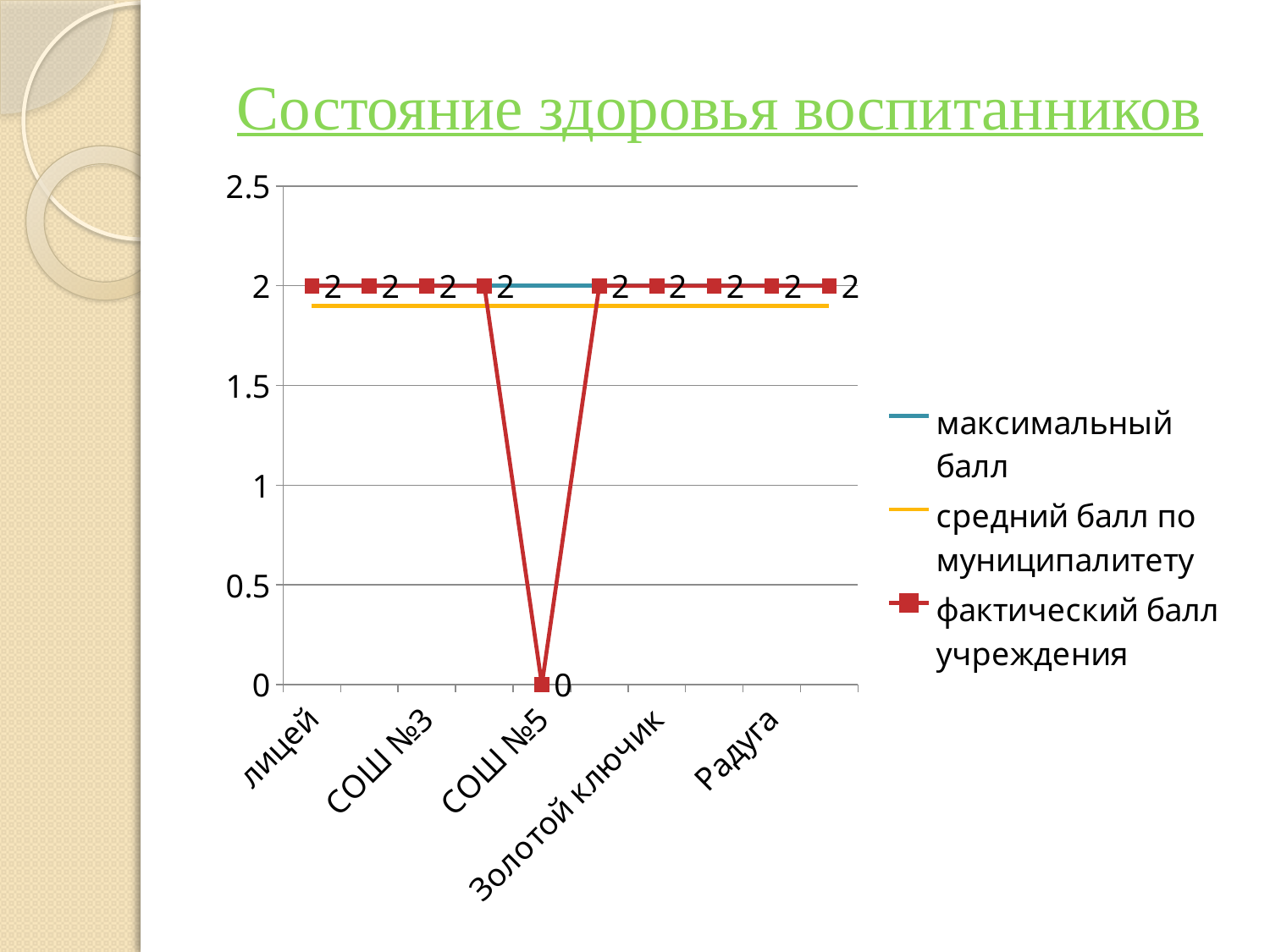
Which labelled institution has the lowest фактический балл учреждения? СОШ №5 What is the фактический балл учреждения value for СОШ №5? 0 What is the difference between the фактический балл учреждения for лицей and for СОШ №5? 2 How many data points are plotted for the фактический балл учреждения series? 10 What is the title of the slide? Состояние здоровья воспитанников What is the фактический балл учреждения value for Радуга? 2 How many series does the legend list? 3 Is the средний балл по муниципалитету line greater or less than 2? less Is the средний балл по муниципалитету line greater or less than 1.5? greater What is the фактический балл учреждения value for лицей? 2 What kind of chart is shown on the slide? line chart Which has the larger фактический балл учреждения, СОШ №3 or СОШ №5? СОШ №3